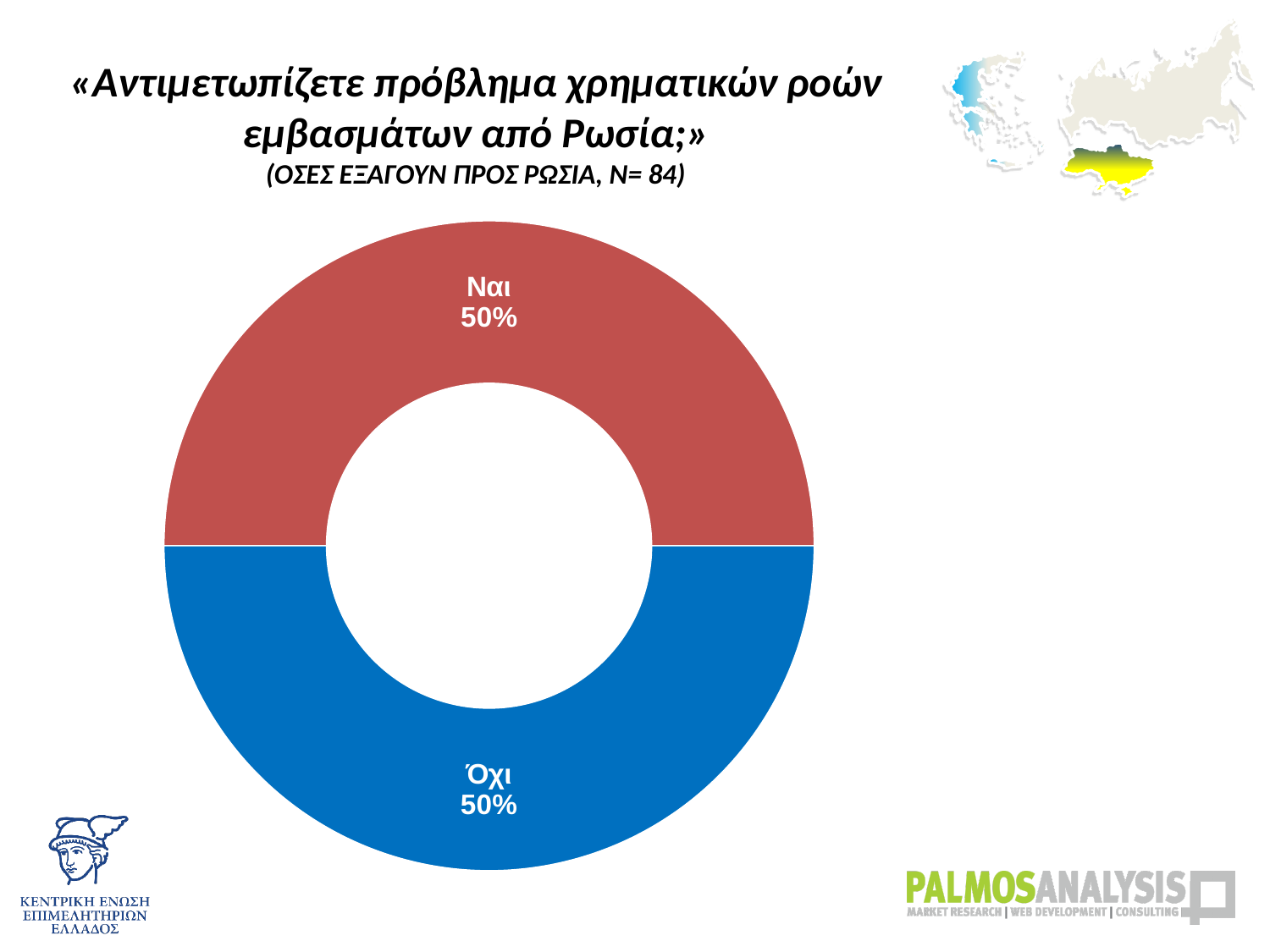
How many categories does the chart show? 2 What kind of chart is shown on the slide? Doughnut (pie) chart What percentage of respondents answered "Ναι"? 50% What percentage of respondents answered "Όχι"? 50% What is the combined total of the "Ναι" and "Όχι" slices? 100% What colour is the "Ναι" slice? Red Is the value for "Ναι" greater or less than 40%? greater Is the value for "Όχι" greater or less than 60%? less What is the difference between the "Ναι" and "Όχι" shares? 0% What is the sample size (N) stated in the chart subtitle? 84 What share of the chart does the "Όχι" slice represent? 50%